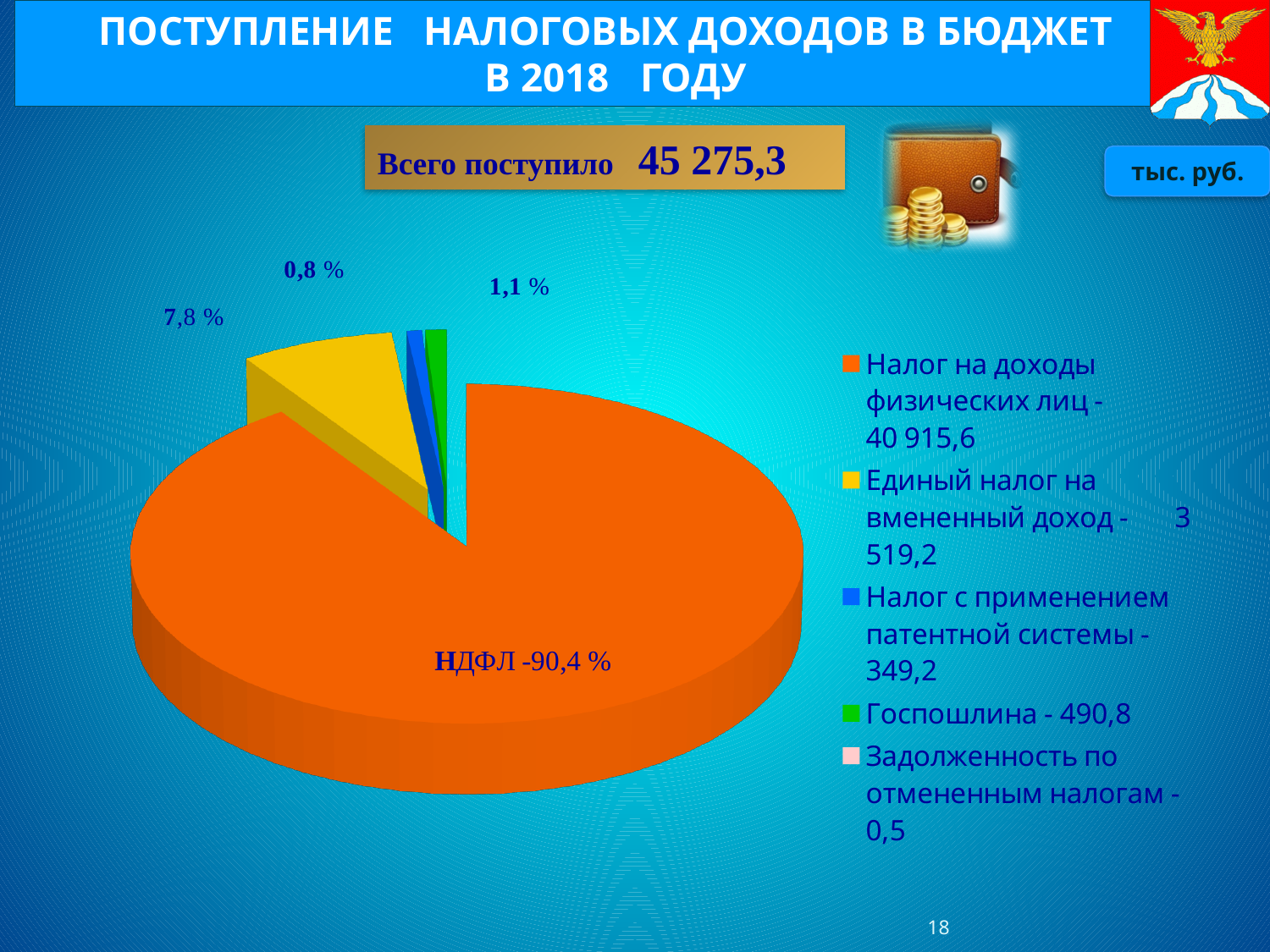
What share of the pie does НДФЛ (Налог на доходы физических лиц) account for? 90,4 % Which category has the smallest value in the legend? Задолженность по отмененным налогам What is the difference between the values for Госпошлина and Налог с применением патентной системы? 141,6 What kind of chart is shown on the slide? pie chart What is the value for Госпошлина according to the legend? 490,8 What colour is the slice for Единый налог на вмененный доход? yellow What share of the pie does Единый налог на вмененный доход account for? 7,8 % How many categories does the legend of the pie chart list? 5 Which is larger: Госпошлина or Налог с применением патентной системы? Госпошлина What share of the pie does Госпошлина account for? 1,1 % What is the value for Налог на доходы физических лиц according to the legend? 40 915,6